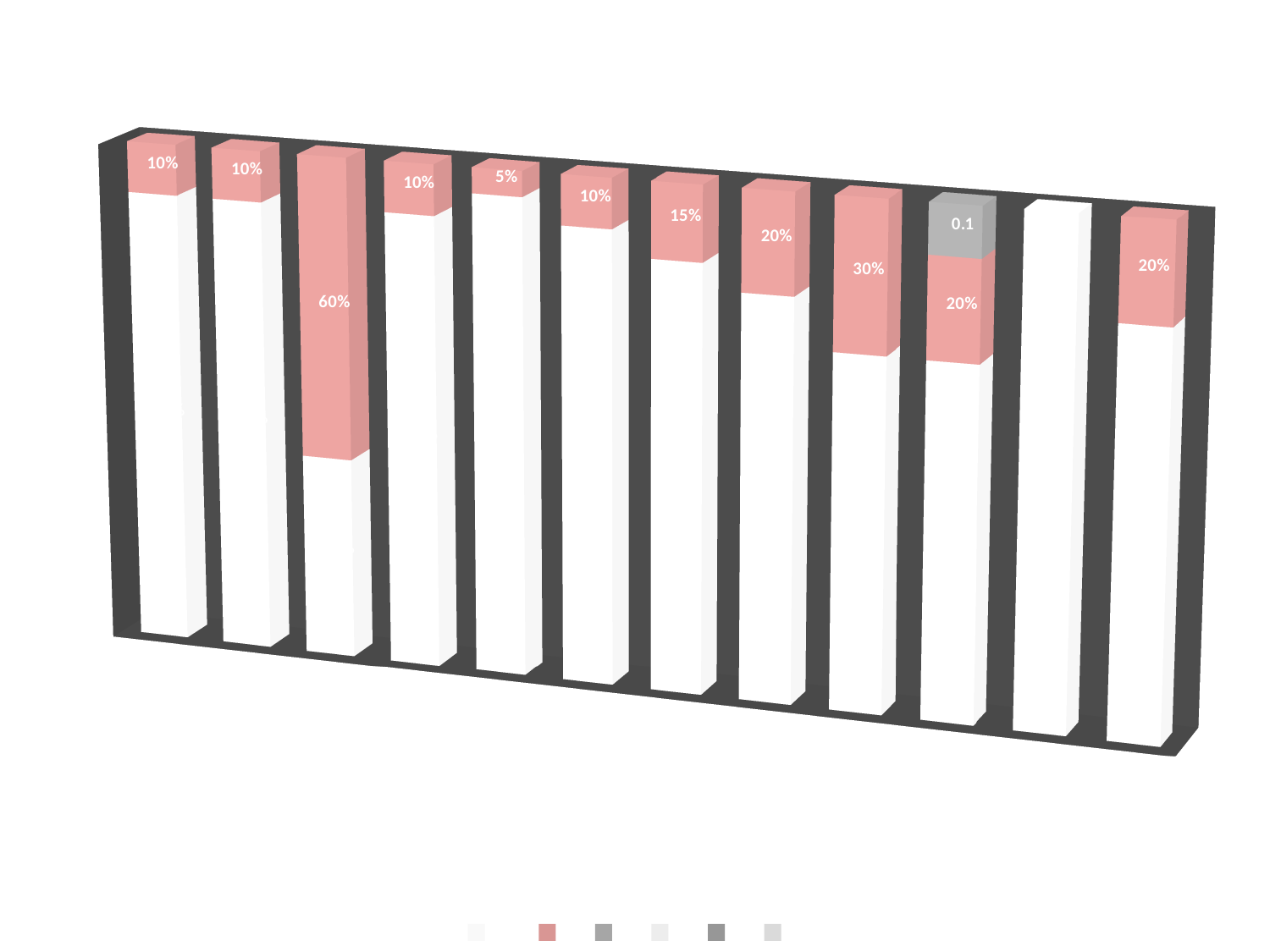
What is the difference between the pink segment of the third bar (60%) and the pink segment of the ninth bar (30%)? 30% What value is labelled on the grey segment of the tenth bar from the left? 0.1 What is the value labelled on the pink segment of the third bar from the left? 60% What kind of chart is shown on the slide? bar chart What is the value labelled on the pink segment of the ninth bar from the left? 30% Which is larger, the pink segment of the third bar or the pink segment of the ninth bar? the third bar Which bar has the smallest labelled pink segment? the fifth bar from the left What colour is the segment labelled 60%? pink How many entries does the legend below the chart show? 6 What is the value labelled on the pink segment of the fifth bar from the left? 5% How many bars are plotted in the chart? 12 Which bar has the largest pink segment? the third bar from the left